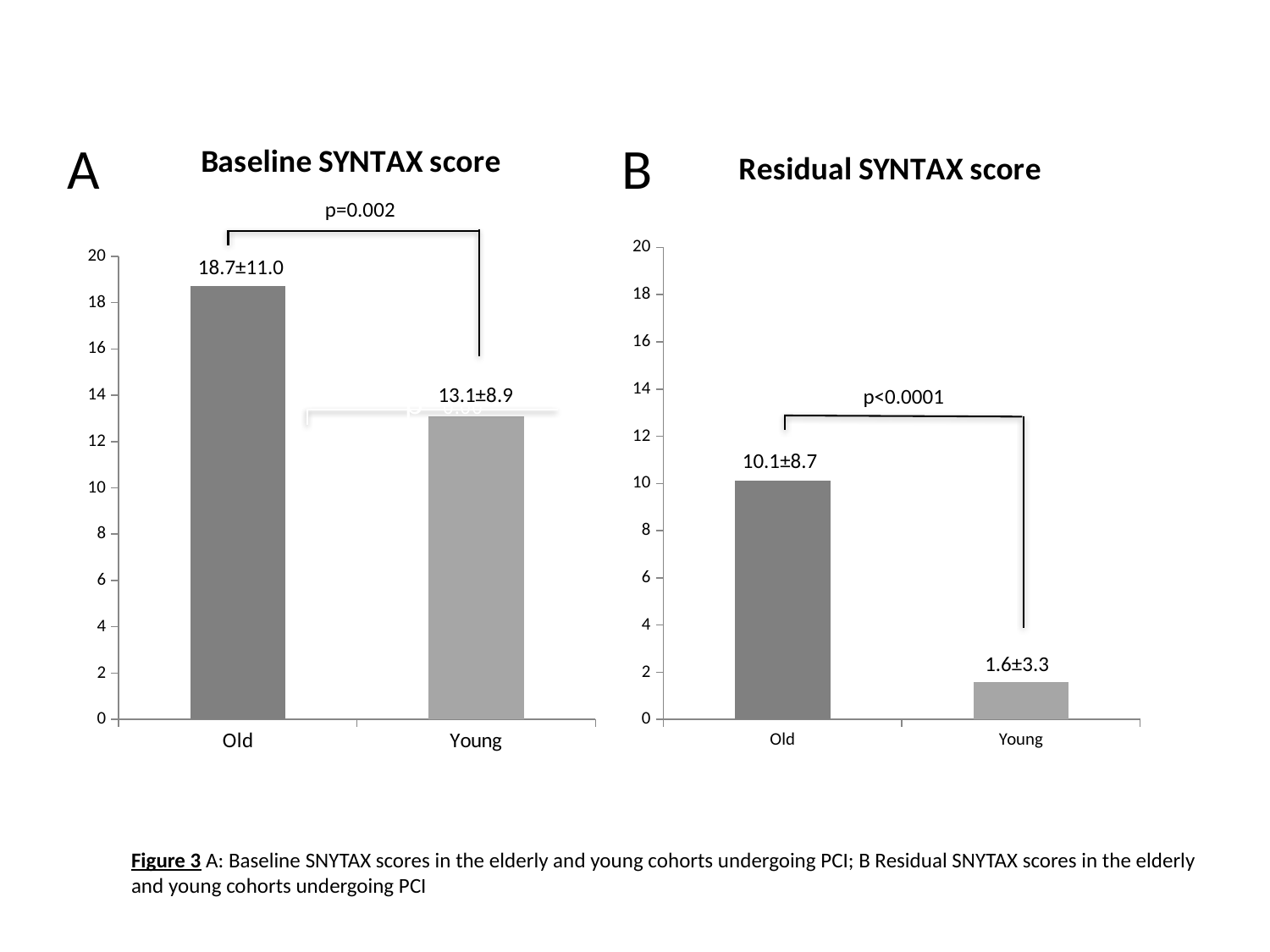
In the Baseline SYNTAX score chart, which group has the higher score? Old In the Residual SYNTAX score chart, what is the value labelled for the Old group? 10.1±8.7 In the Residual SYNTAX score chart, what is the difference between the mean scores of the Old and Young groups? 8.5 In the Residual SYNTAX score chart, what is the value labelled for the Young group? 1.6±3.3 What p-value is shown on the Residual SYNTAX score chart? p<0.0001 What kind of chart is the Residual SYNTAX score chart? Bar chart In the Baseline SYNTAX score chart, what is the difference between the mean scores of the Old and Young groups? 5.6 In the Baseline SYNTAX score chart, what is the value labelled for the Young group? 13.1±8.9 In the Baseline SYNTAX score chart, what is the value labelled for the Old group? 18.7±11.0 How many groups are shown on the x axis of the Baseline SYNTAX score chart? 2 Is the mean Residual SYNTAX score for the Old group greater or less than 10? greater In the Residual SYNTAX score chart, which group has the lower score? Young